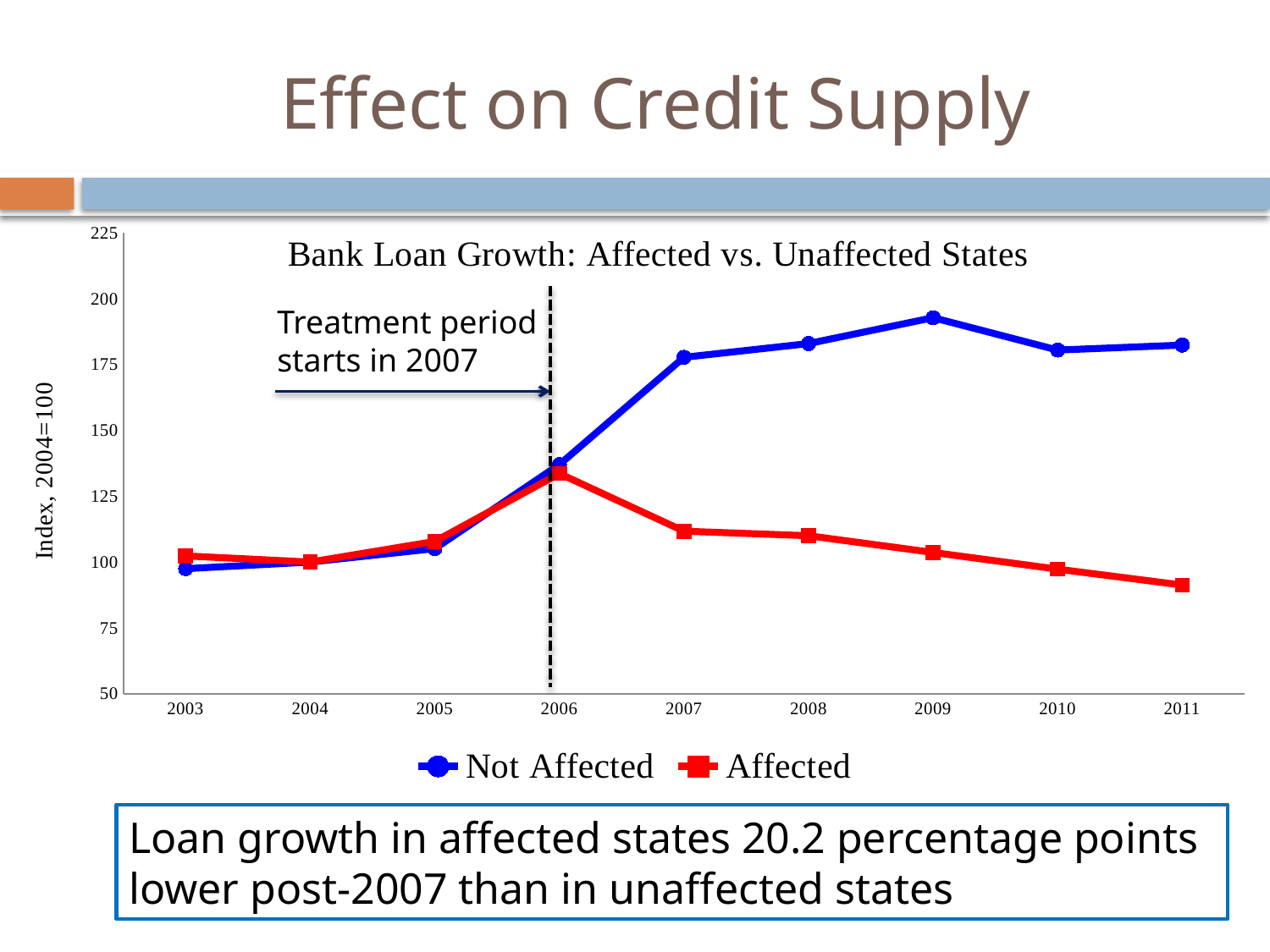
In which year does the Not Affected series reach its highest value? 2009 Which series has the larger value in 2011, Not Affected or Affected? Not Affected What is the value of the Affected series in 2004? 100 Is the value for Affected in 2011 greater or less than 100? less In which year does the Affected series reach its lowest value? 2011 How many series does the legend list? 2 What is the label on the y axis? Index, 2004=100 What kind of chart is shown on the slide? line chart Is the value for Not Affected in 2009 greater or less than 175? greater How many years are plotted along the x axis? 9 In which year does the Affected series reach its highest value? 2006 What is the title of the chart? Bank Loan Growth: Affected vs. Unaffected States